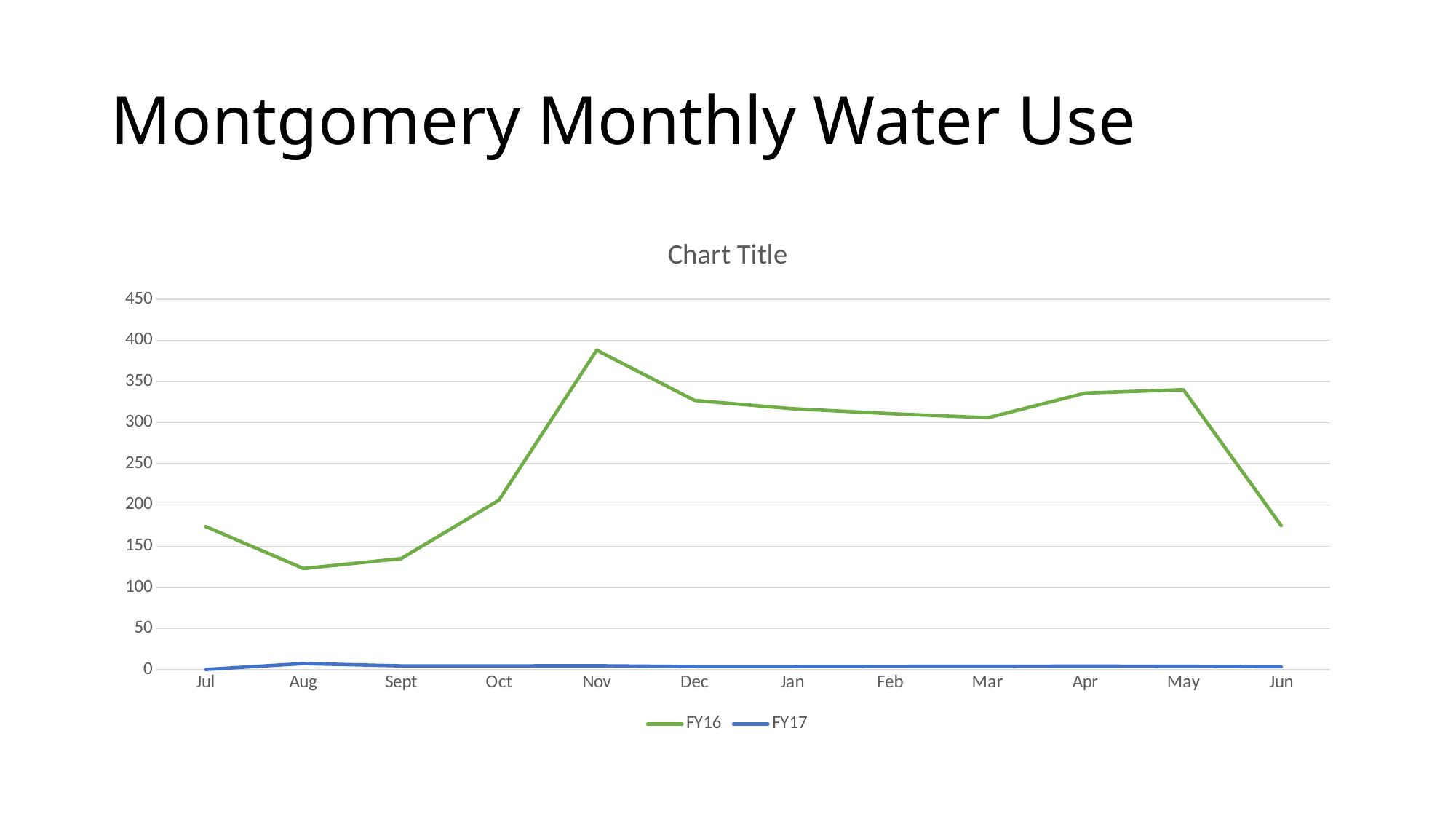
Which colour is used for the FY17 series? blue Which series has the larger value in Nov, FY16 or FY17? FY16 Which is larger for FY16, the value for Nov or the value for Dec? Nov Is the FY16 value for Aug greater or less than 150? less In which month does the FY16 series reach its highest value? Nov Does the FY16 series rise or fall from Sept to Nov? rise How many months are plotted along the x axis? 12 How many series does the legend list? 2 Is the FY16 value for Dec greater or less than 350? less Is the FY16 value for Jun greater or less than 200? less What kind of chart is shown on the slide? line chart